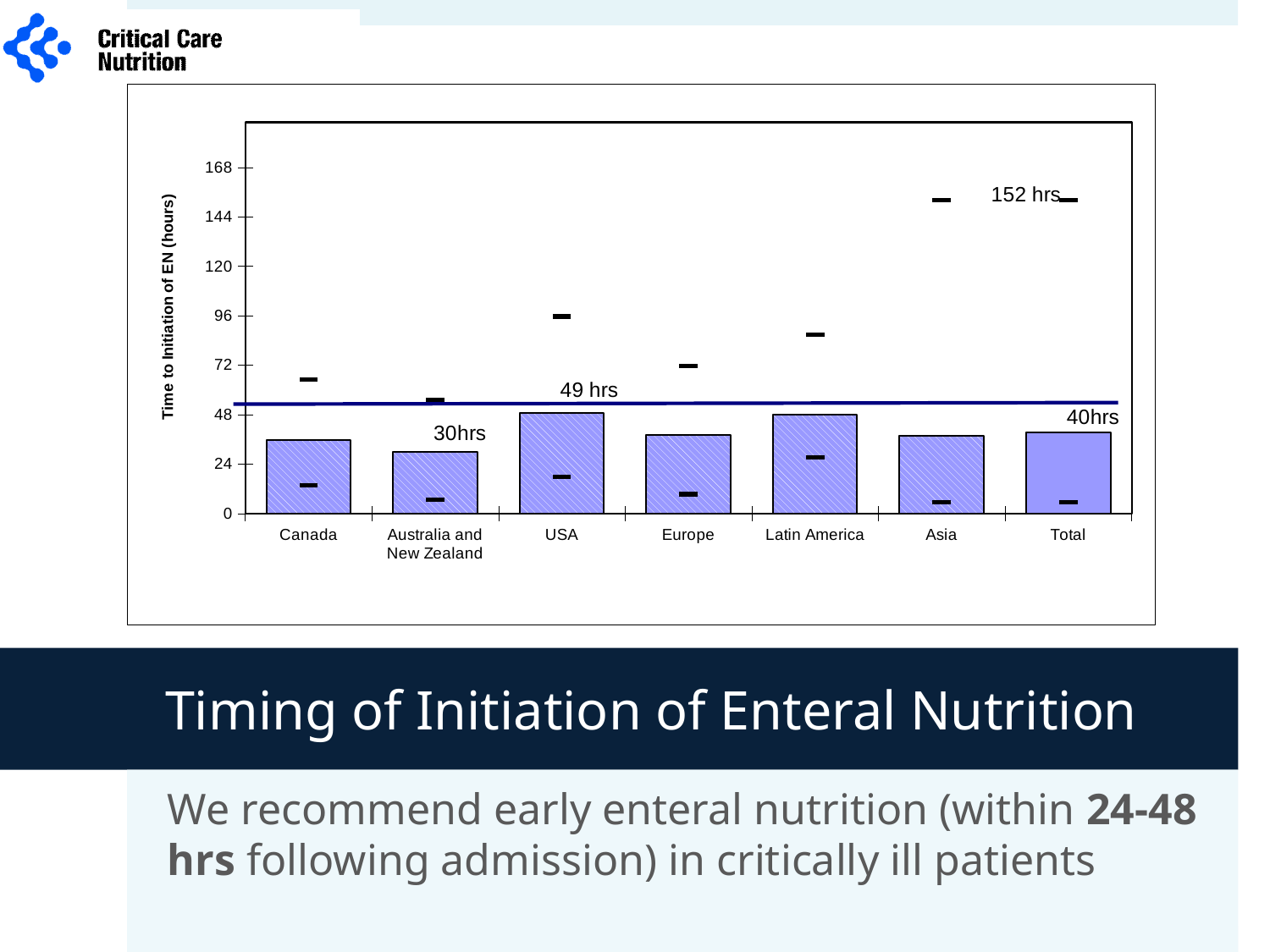
What is the title of the y axis? Time to Initiation of EN (hours) What kind of chart is shown on the slide? bar chart Is the value for Latin America greater or less than 72? less What is the difference between the values for USA and Australia and New Zealand? 19 hrs How many categories are shown on the x axis? 7 What is the value for Total? 40hrs Is the value for Asia greater or less than 48? less Which is larger, the value for USA or the value for Australia and New Zealand? USA What is the value for USA? 49 hrs Which category has the lowest bar? Australia and New Zealand Is the value for Canada greater or less than 48? less What is the value for Australia and New Zealand? 30hrs